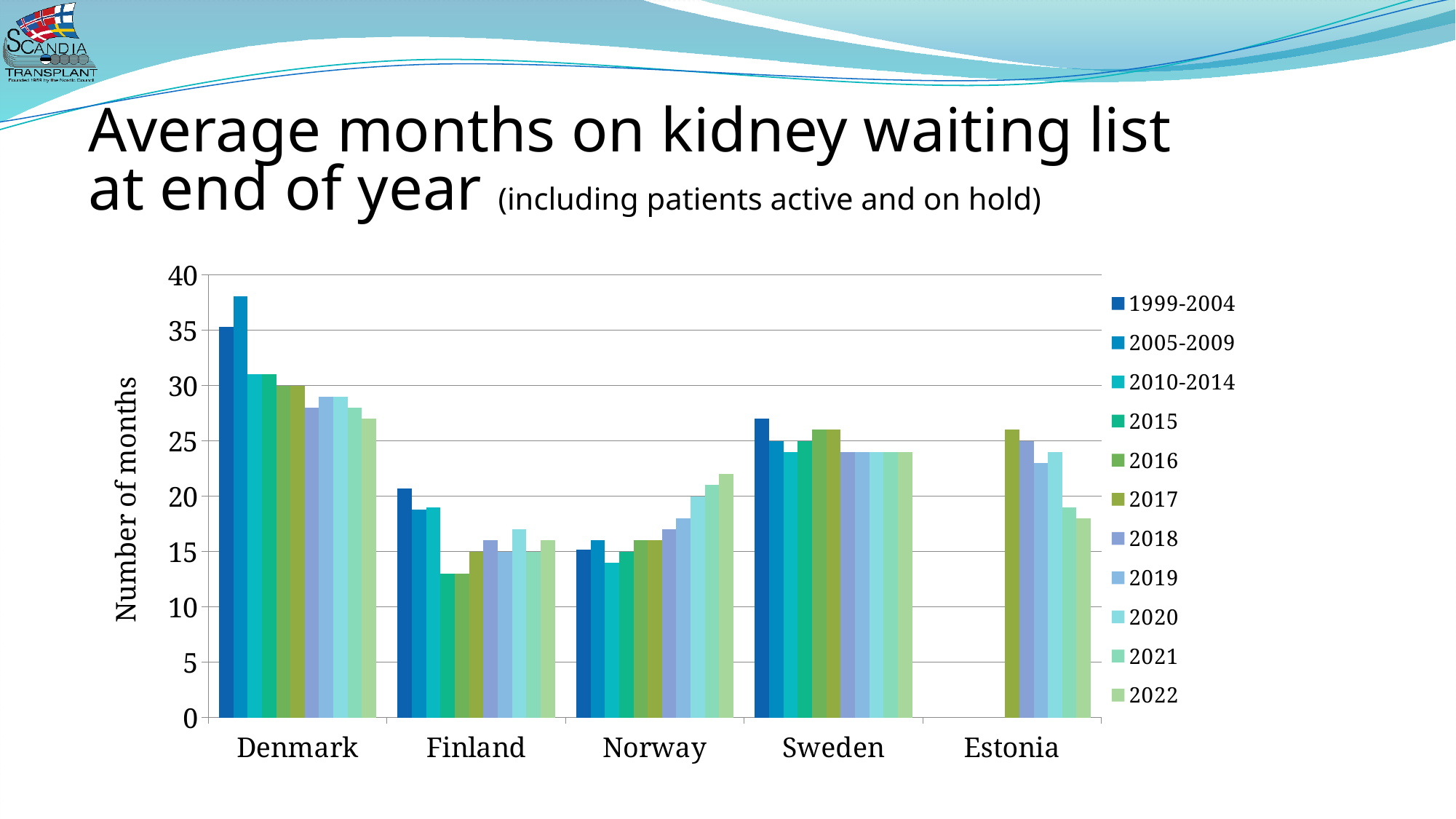
Which is larger, the 1999-2004 value for Denmark or the 1999-2004 value for Sweden? Denmark What kind of chart is shown on the slide? bar chart Do the values for Norway rise or fall from 2015 to 2022? rise What is the label on the y axis of the chart? Number of months Which country has the tallest bar in the chart? Denmark Is the value for Estonia in 2022 greater or less than 20? less How many series does the legend list? 11 Is the value for Norway in 2022 greater or less than 20? greater How many countries are shown on the x axis of the chart? 5 Is the value for Denmark in 2005-2009 greater or less than 35? greater Which country has the lowest value for 2022? Finland